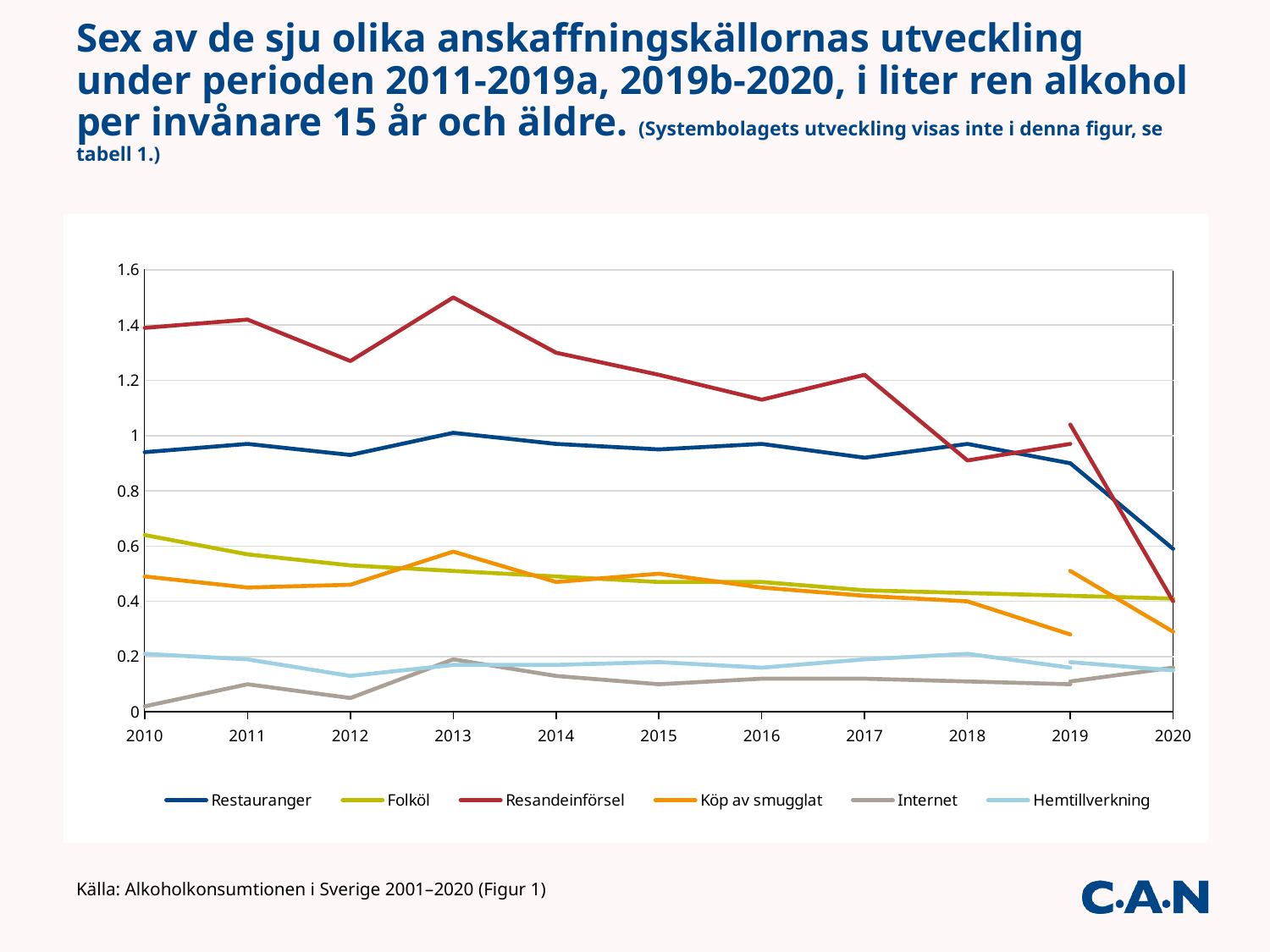
Which is larger in 2010, Folköl or Köp av smugglat? Folköl Is the value for Resandeinförsel in 2016 greater or less than 1? greater Which series has the lowest value in 2010? Internet How many years are shown along the x axis? 11 How many series does the legend list? 6 Is the value for Internet in 2010 greater or less than 0.2? less Is the value for Resandeinförsel in 2013 greater or less than 1.4? greater What kind of chart is shown on the slide? Line chart What colour is the Resandeinförsel line in the legend? Red Which series has the highest value in 2013? Resandeinförsel Does the Folköl series rise or fall from 2010 to 2020? Fall